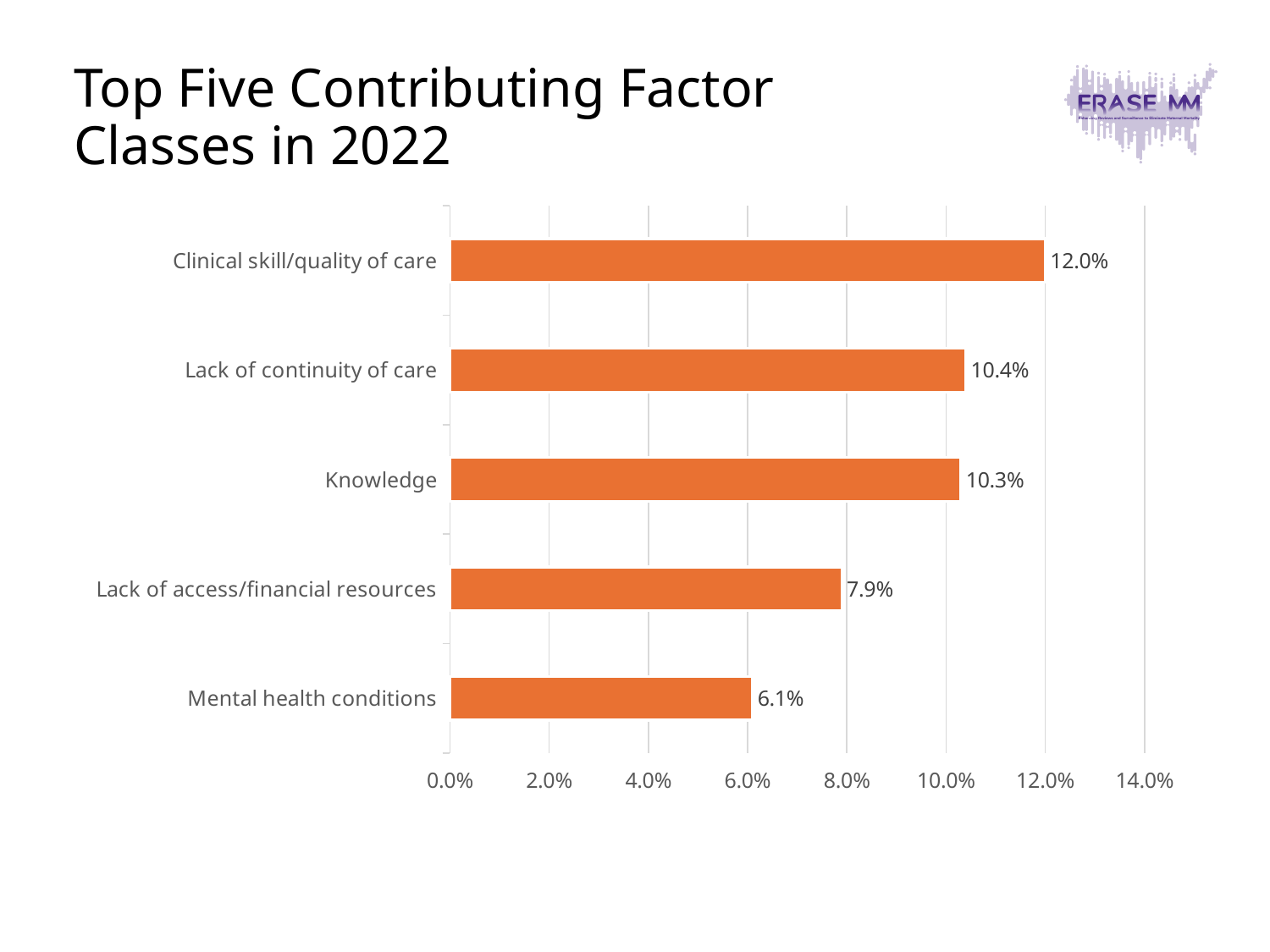
What is the value for Clinical skill/quality of care? 12.0% Is the value for Lack of access/financial resources greater or less than 8.0%? less How many contributing factor classes are shown in the chart? 5 What kind of chart is shown on the slide? Bar chart Which contributing factor class has the lowest value? Mental health conditions What is the value for Lack of continuity of care? 10.4% What is the difference between the values for Clinical skill/quality of care and Mental health conditions? 5.9% What is the value for Mental health conditions? 6.1% What is the value for Lack of access/financial resources? 7.9% Which is larger, the value for Lack of access/financial resources or the value for Mental health conditions? Lack of access/financial resources Which contributing factor class has the highest value? Clinical skill/quality of care What is the value for Knowledge? 10.3%